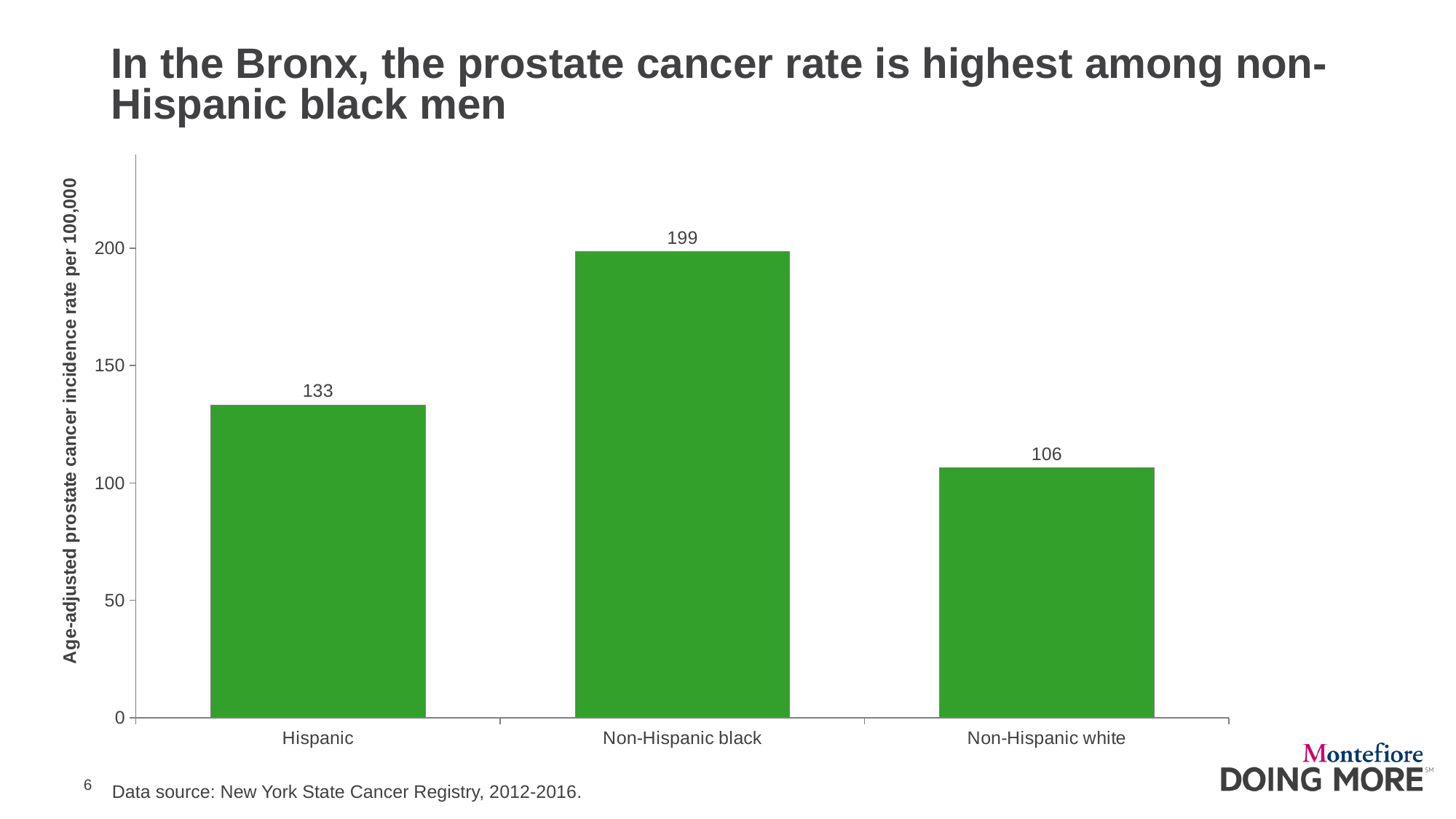
What is the age-adjusted prostate cancer incidence rate per 100,000 for Hispanic men? 133 Which group has a higher prostate cancer incidence rate, Hispanic or Non-Hispanic white? Hispanic What is the age-adjusted prostate cancer incidence rate per 100,000 for Non-Hispanic black men? 199 What is the difference between the prostate cancer incidence rates for Non-Hispanic black men and Non-Hispanic white men? 93 What kind of chart is shown on the slide? Bar chart Which group has the highest prostate cancer incidence rate? Non-Hispanic black Which group has the lowest prostate cancer incidence rate? Non-Hispanic white What is the difference between the prostate cancer incidence rates for Non-Hispanic black men and Hispanic men? 66 Is the prostate cancer incidence rate for Hispanic men greater or less than 150? less What is the label of the vertical axis? Age-adjusted prostate cancer incidence rate per 100,000 What is the age-adjusted prostate cancer incidence rate per 100,000 for Non-Hispanic white men? 106 How many groups are shown in the chart? 3